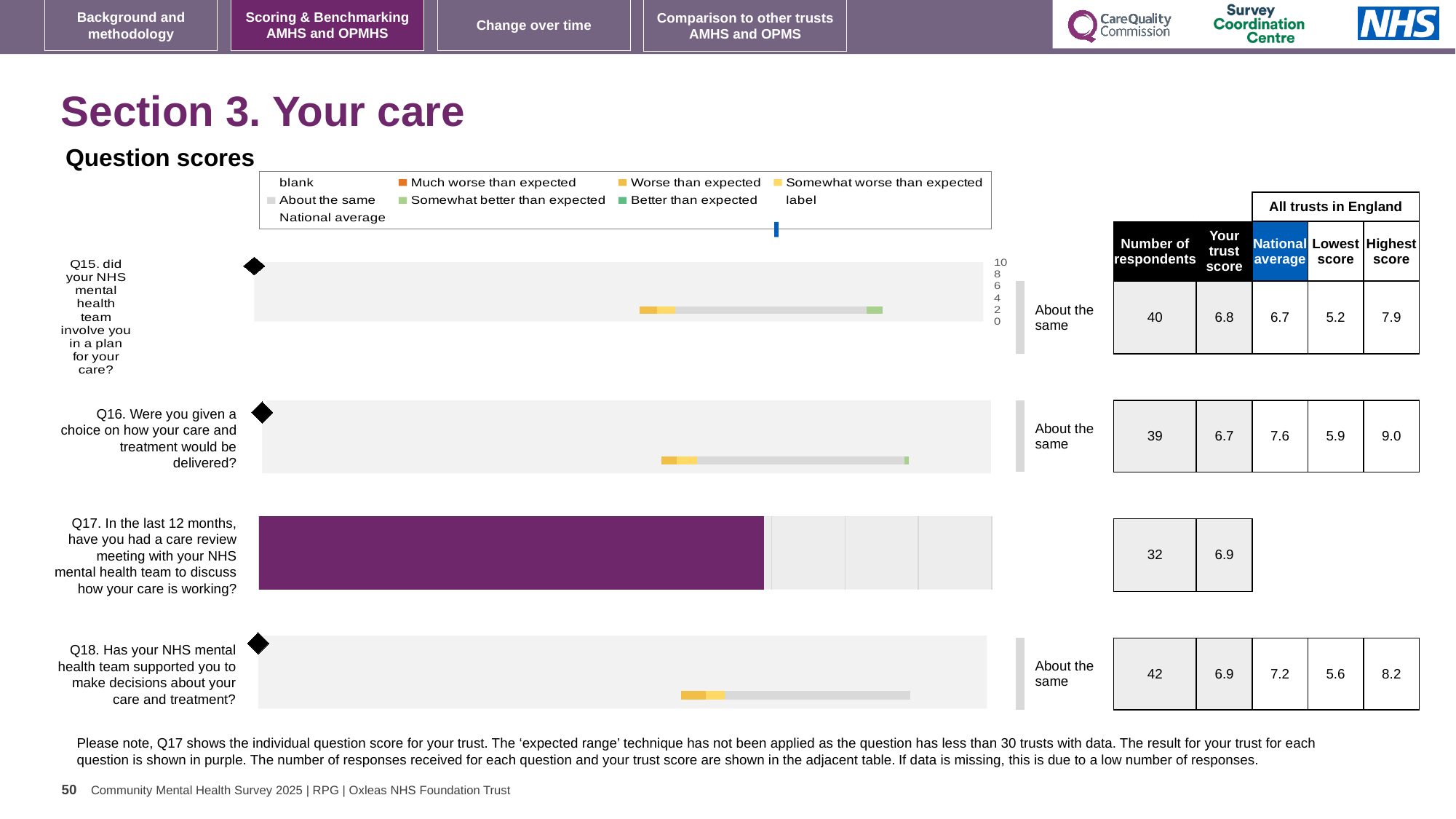
For Q15, which is larger: the trust score or the national average? Trust score Which question has the lowest 'Lowest score' among all trusts in England? Q15 What is the difference between the national average and the trust score for Q18? 0.3 Which question has the highest 'Highest score' among all trusts in England? Q16 What is the trust score for Q17 (care review meeting in the last 12 months)? 6.9 What is the trust score for Q15 (did your NHS mental health team involve you in a plan for your care)? 6.8 What is the difference between the highest score and the lowest score for Q16? 3.1 What kind of chart is used to show the question scores? Bar chart Which question's bar is shown in purple because the expected range technique was not applied? Q17 How many respondents answered Q18 (has your NHS mental health team supported you to make decisions about your care and treatment)? 42 How many questions are shown in the Section 3 question scores chart? 4 What is the national average for Q16 (were you given a choice on how your care and treatment would be delivered)? 7.6